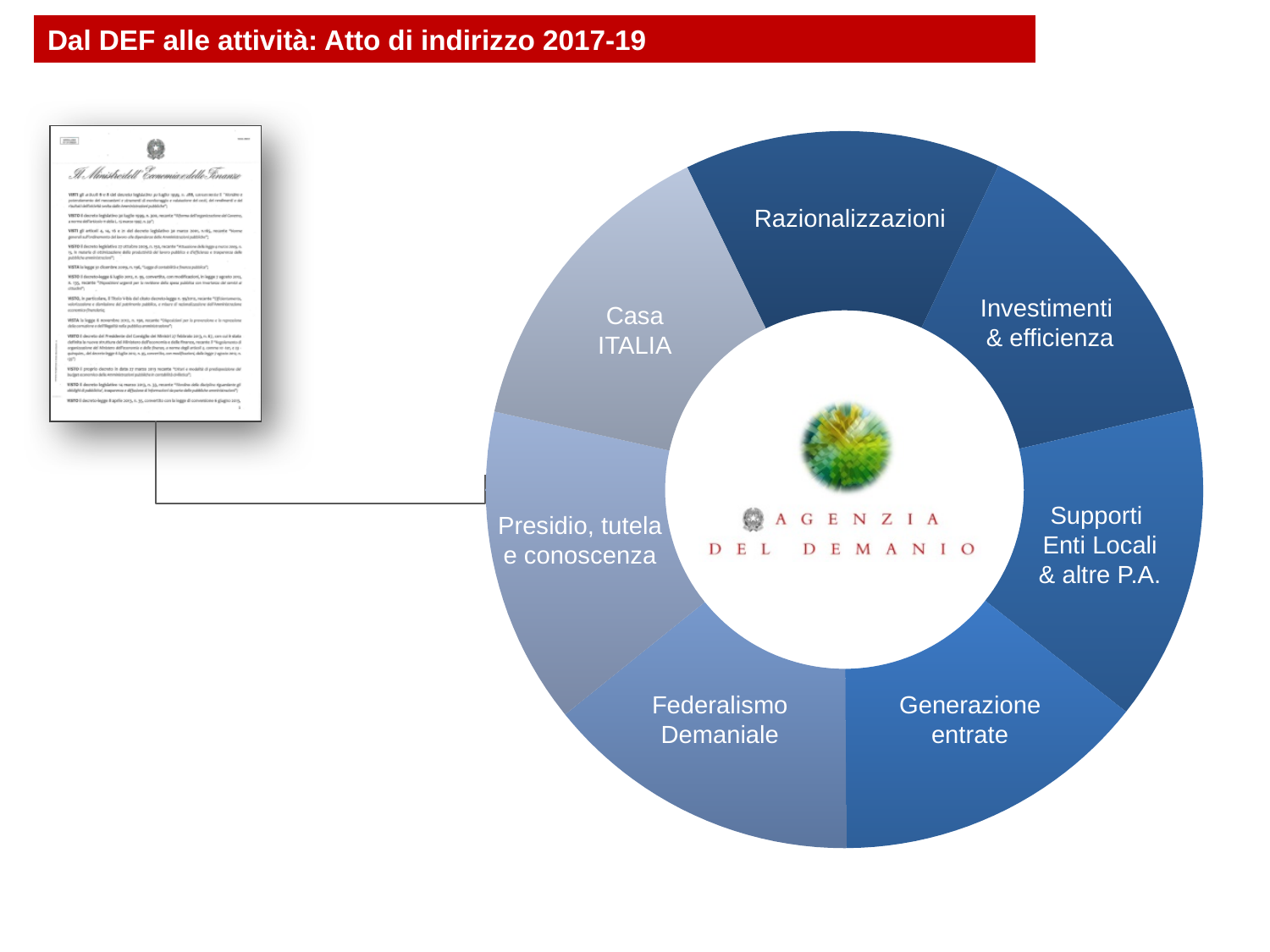
Which segment of the donut chart is labelled 'Casa ITALIA' adjacent to? Razionalizzazioni and Presidio, tutela e conoscenza What is the title of the slide containing the donut chart? Dal DEF alle attività: Atto di indirizzo 2017-19 Which segment of the donut chart is labelled at the top? Razionalizzazioni Which segment of the donut chart sits between 'Investimenti & efficienza' and 'Generazione entrate'? Supporti Enti Locali & altre P.A. Which segment of the donut chart is located directly to the left of 'Generazione entrate' at the bottom? Federalismo Demaniale What kind of chart is shown on the slide? Donut chart Whose logo appears in the centre of the donut chart? Agenzia del Demanio How many segments does the donut chart have? 7